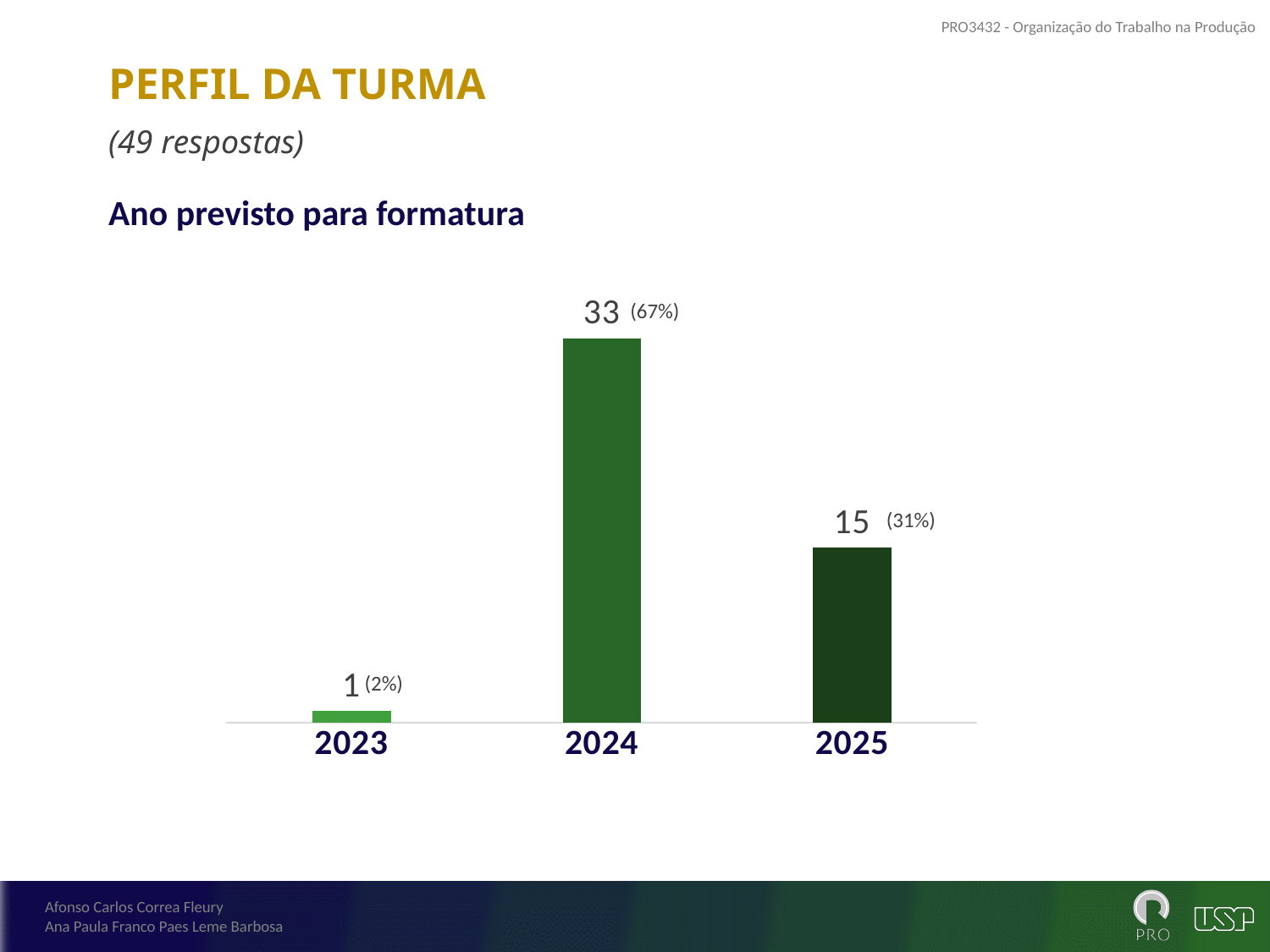
Which graduation year has the highest number of respondents? 2024 Which has more respondents, 2023 or 2025? 2025 What is the difference between the number of respondents for 2024 and 2025? 18 What is the heading above the chart? Ano previsto para formatura What is the total number of respondents across the three years shown? 49 How many respondents expect to graduate in 2024? 33 Which graduation year has the lowest number of respondents? 2023 How many respondents expect to graduate in 2025? 15 How many graduation years are shown in the chart? 3 What percentage of respondents expect to graduate in 2025? 31% How many respondents expect to graduate in 2023? 1 What kind of chart is shown on the slide? Bar chart